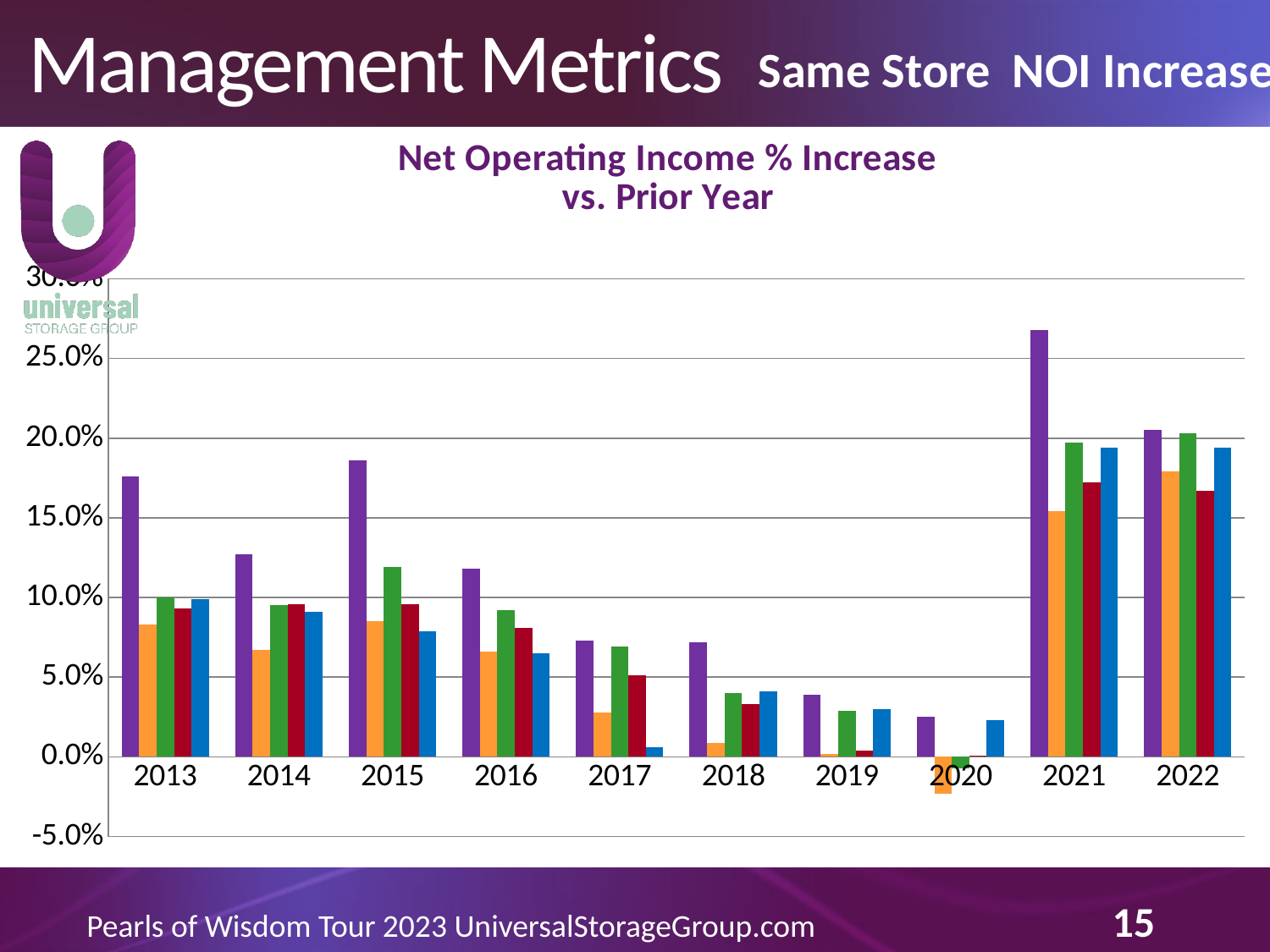
Which is larger, the purple bar for 2015 or the purple bar for 2016? 2015 Is the purple bar for 2021 greater or less than 25.0%? greater How many bars are plotted for each year in the chart? 5 Do the purple bars rise or fall from 2016 to 2020? fall Is the purple bar for 2013 greater or less than 15.0%? greater How many years are shown along the x axis of the chart? 10 In which year is the purple bar the shortest? 2020 Is the orange bar for 2020 greater or less than 0.0%? less What kind of chart is shown on the slide? bar chart What is the title of the chart? Net Operating Income % Increase vs. Prior Year In which year is the purple bar the tallest? 2021